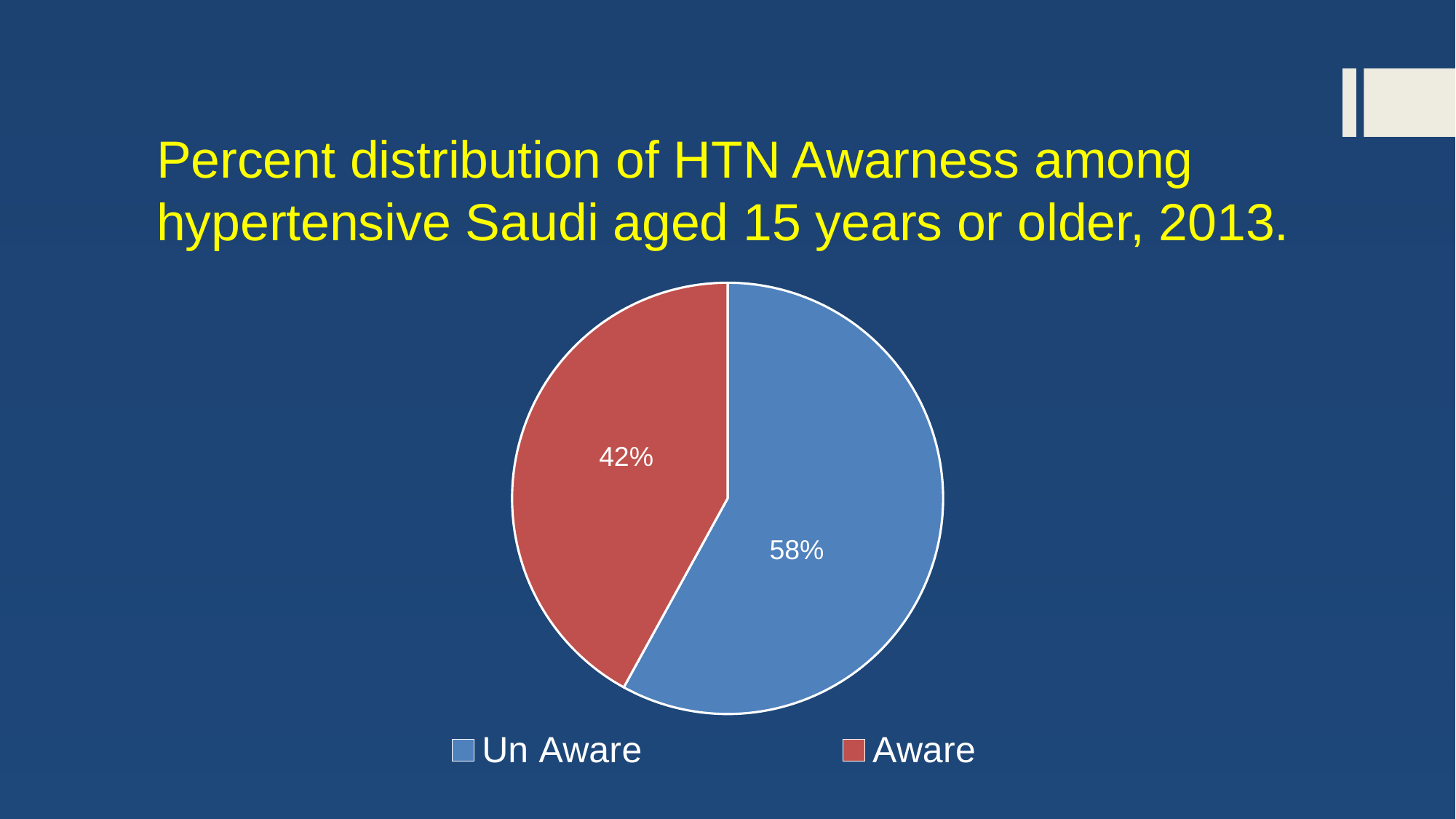
What kind of chart is shown on the slide? Pie chart What percentage of the pie is labelled Aware? 42% What is the difference in percentage points between the Un Aware and Aware slices? 16 Which is larger, the Aware slice or the Un Aware slice? Un Aware What is the title of the chart on the slide? Percent distribution of HTN Awarness among hypertensive Saudi aged 15 years or older, 2013. Which slice is the smallest? Aware How many entries does the legend list? 2 Which slice is the largest? Un Aware What percentage of the pie is labelled Un Aware? 58% What share of the pie does the Aware slice represent? 42% What colour is the Un Aware slice? Blue How many slices does the pie chart have? 2